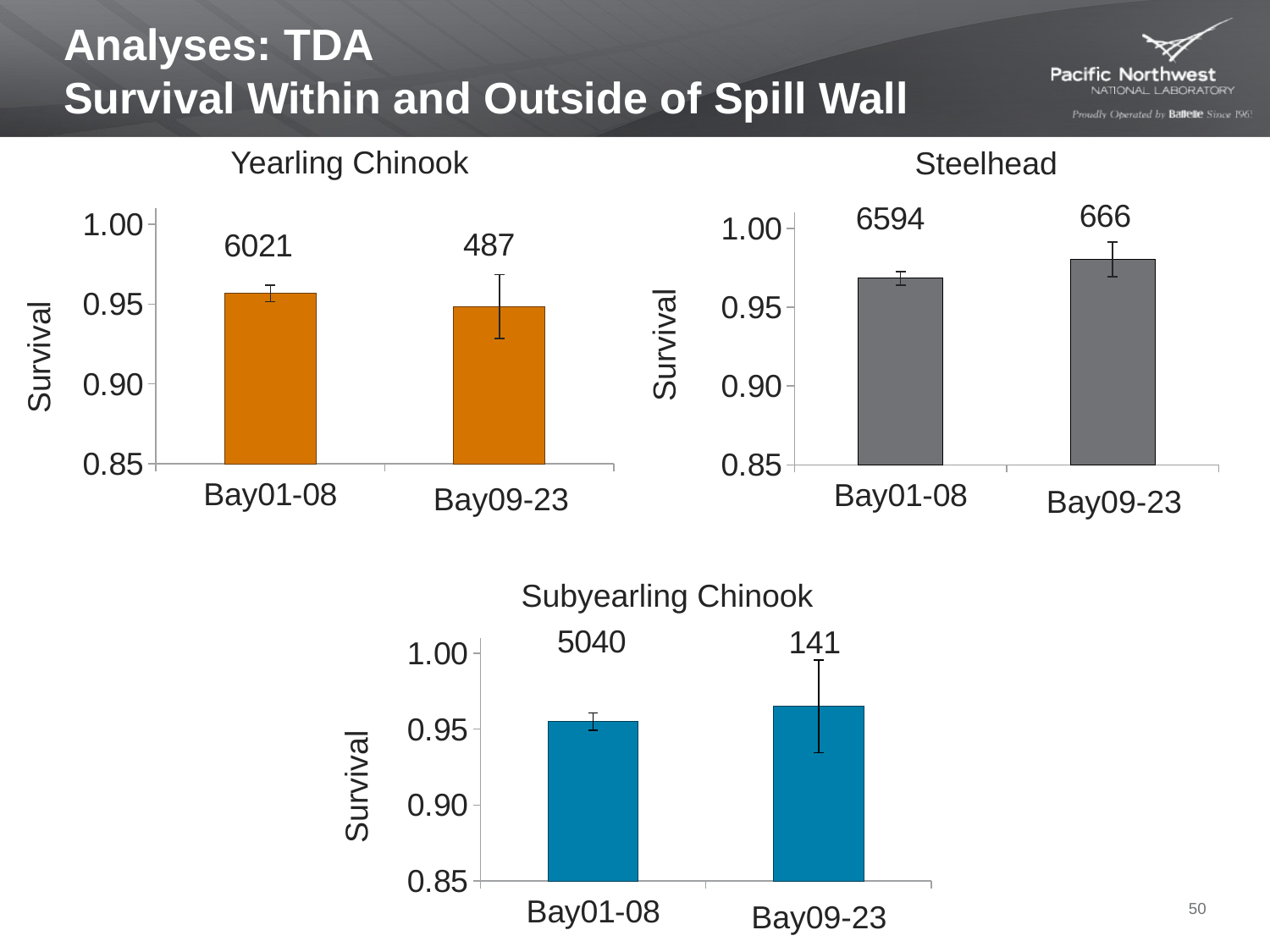
What is the y-axis label on the Subyearling Chinook chart? Survival In the Subyearling Chinook chart, what number is printed above the Bay01-08 bar? 5040 In the Steelhead chart, what number is printed above the Bay09-23 bar? 666 In the Steelhead chart, what number is printed above the Bay01-08 bar? 6594 How many bars does the Steelhead chart show? 2 In the Steelhead chart, which bay group has the higher survival, Bay01-08 or Bay09-23? Bay09-23 In the Subyearling Chinook chart, is the survival value for Bay09-23 greater or less than 0.90? greater In the Yearling Chinook chart, what number is printed above the Bay09-23 bar? 487 In the Subyearling Chinook chart, what number is printed above the Bay09-23 bar? 141 In the Steelhead chart, is the survival value for Bay09-23 greater or less than 0.95? greater In the Yearling Chinook chart, what number is printed above the Bay01-08 bar? 6021 What kind of chart is the Yearling Chinook chart? bar chart